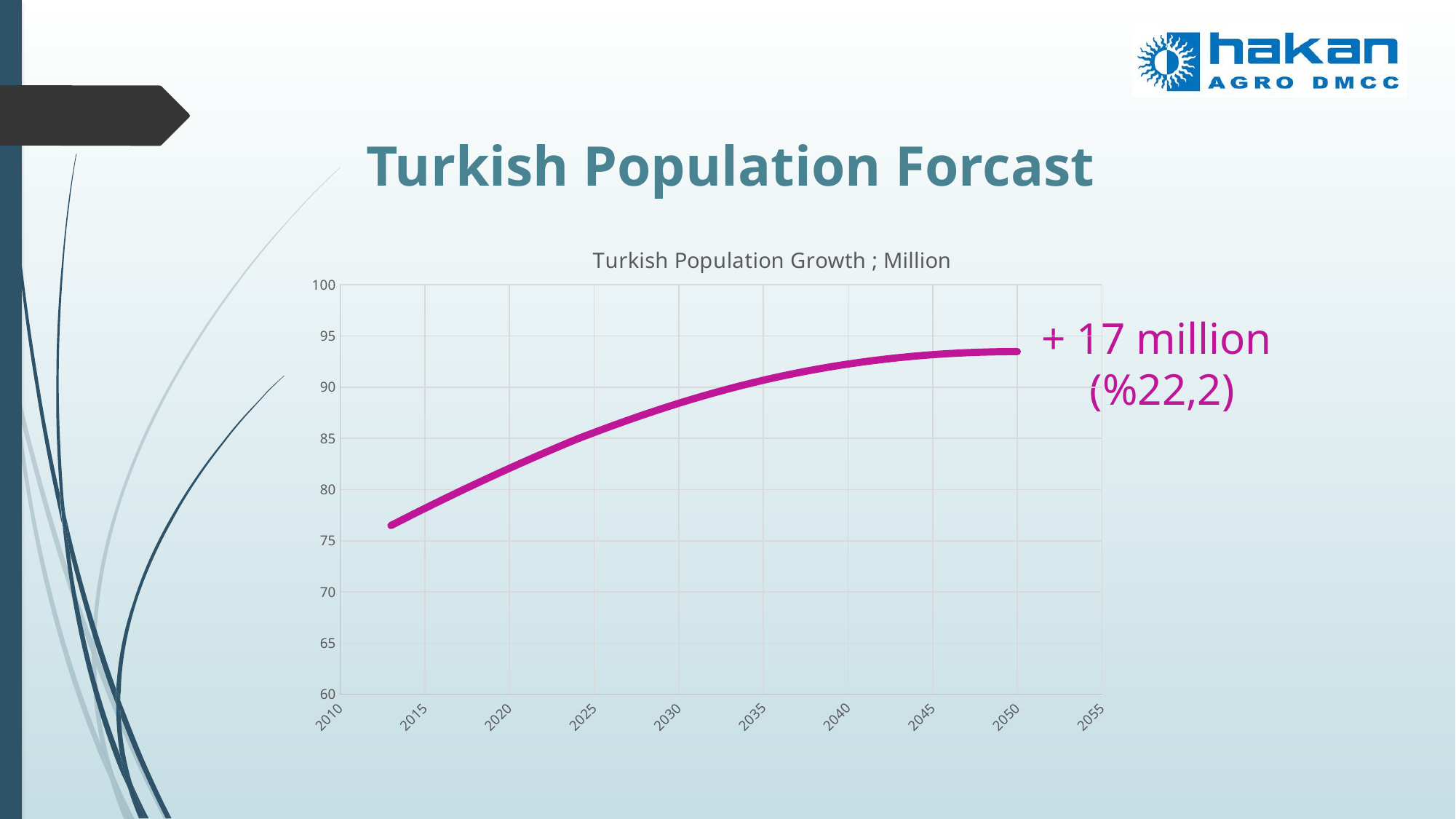
Which year has the larger value, 2015 or 2050? 2050 Is the value for 2045 greater or less than 90? greater What is the title of the chart? Turkish Population Growth ; Million What kind of chart is shown on the slide? line chart Is the value for 2050 greater or less than 90? greater Is the value for 2040 greater or less than 95? less What annotation is written next to the end of the line? + 17 million (%22,2) Which year has the smaller value, 2025 or 2035? 2025 Does the Turkish population value rise or fall from left to right along the x axis? rise